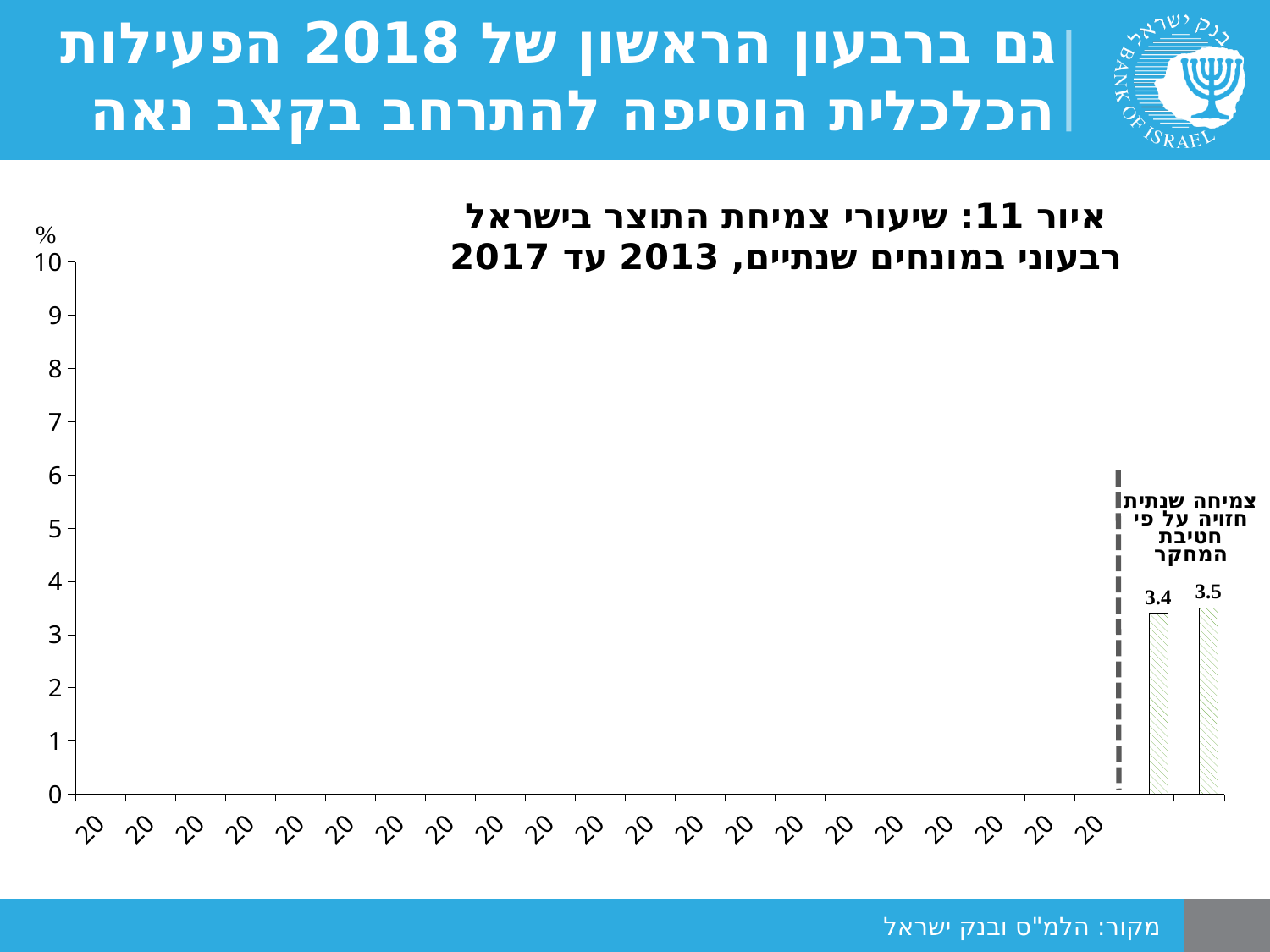
How many bars with printed data labels appear on the chart? 2 What is the value printed on the rightmost bar of the chart? 3.5 What is the value printed on the left of the two forecast bars at the right of the chart? 3.4 What is the highest value shown on the y axis? 10 What unit is shown at the top of the y axis? % What is the highest printed value among the bars on the chart? 3.5 Which of the two forecast bars at the right of the chart is taller, the left one or the right one? the right one Is the value of the bar labelled 3.4 greater or less than 3? greater Is the value of the rightmost bar greater or less than 4? less What kind of chart is shown on the slide? bar chart What is the difference between the two forecast bar values, 3.5 and 3.4? 0.1 What is the lowest printed value among the bars on the chart? 3.4